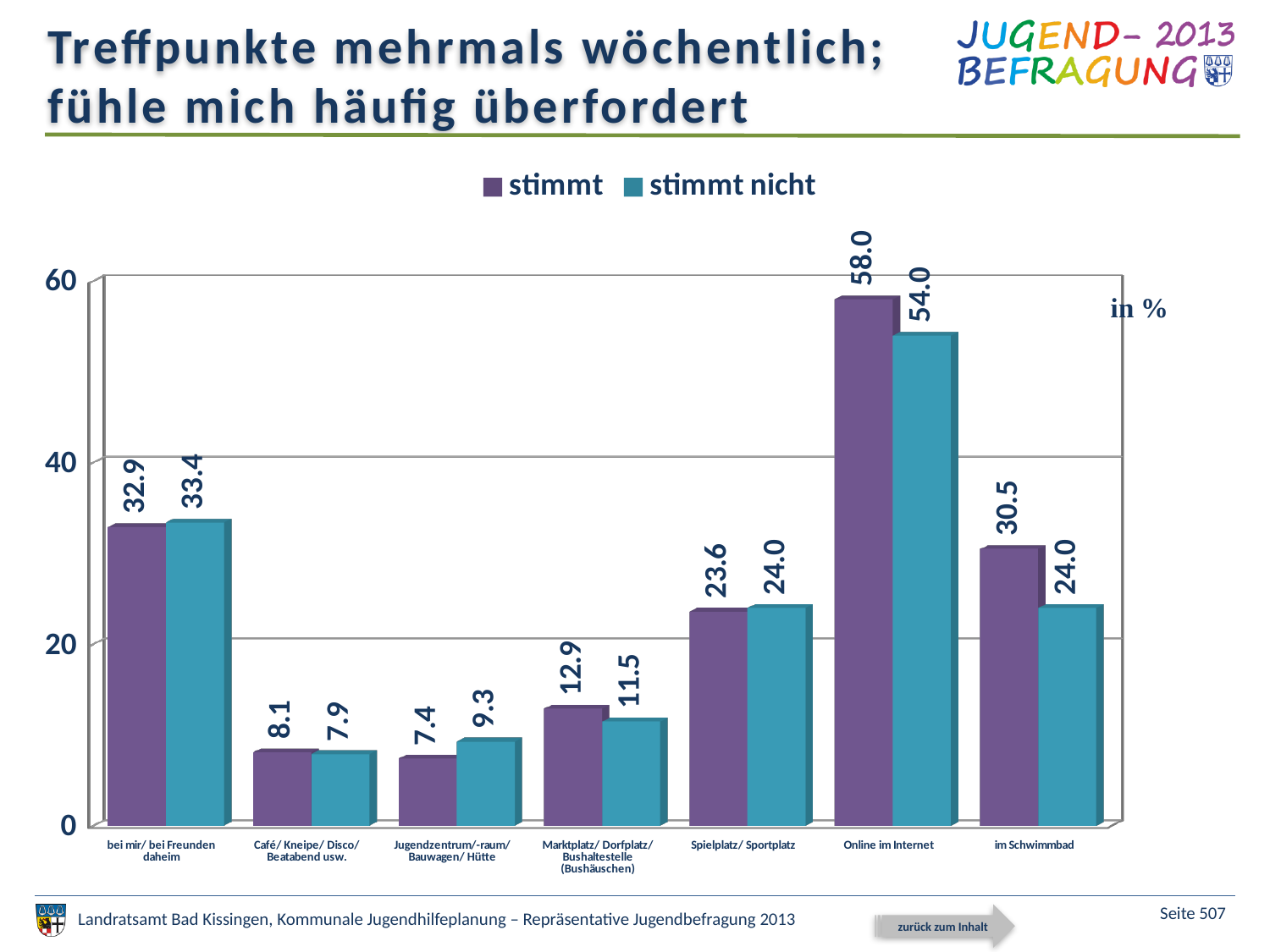
How many series does the legend list? 2 Which category has the lowest value for "stimmt"? Jugendzentrum/-raum/ Bauwagen/ Hütte What kind of chart is shown on the slide? bar chart Which category has the highest value for "stimmt nicht"? Online im Internet What is the value for "stimmt" in the "Online im Internet" category? 58.0 What is the value for "stimmt nicht" in the "im Schwimmbad" category? 24.0 What is the difference between "stimmt" and "stimmt nicht" in the "im Schwimmbad" category? 6.5 How many categories are shown on the x axis? 7 Is the value for "stimmt" in the "Spielplatz/ Sportplatz" category greater or less than 20? greater In the "Marktplatz/ Dorfplatz/ Bushaltestelle (Bushäuschen)" category, which series has the larger value, "stimmt" or "stimmt nicht"? stimmt What is the value for "stimmt" in the "Jugendzentrum/-raum/ Bauwagen/ Hütte" category? 7.4 What unit is indicated for the values in the chart? in %